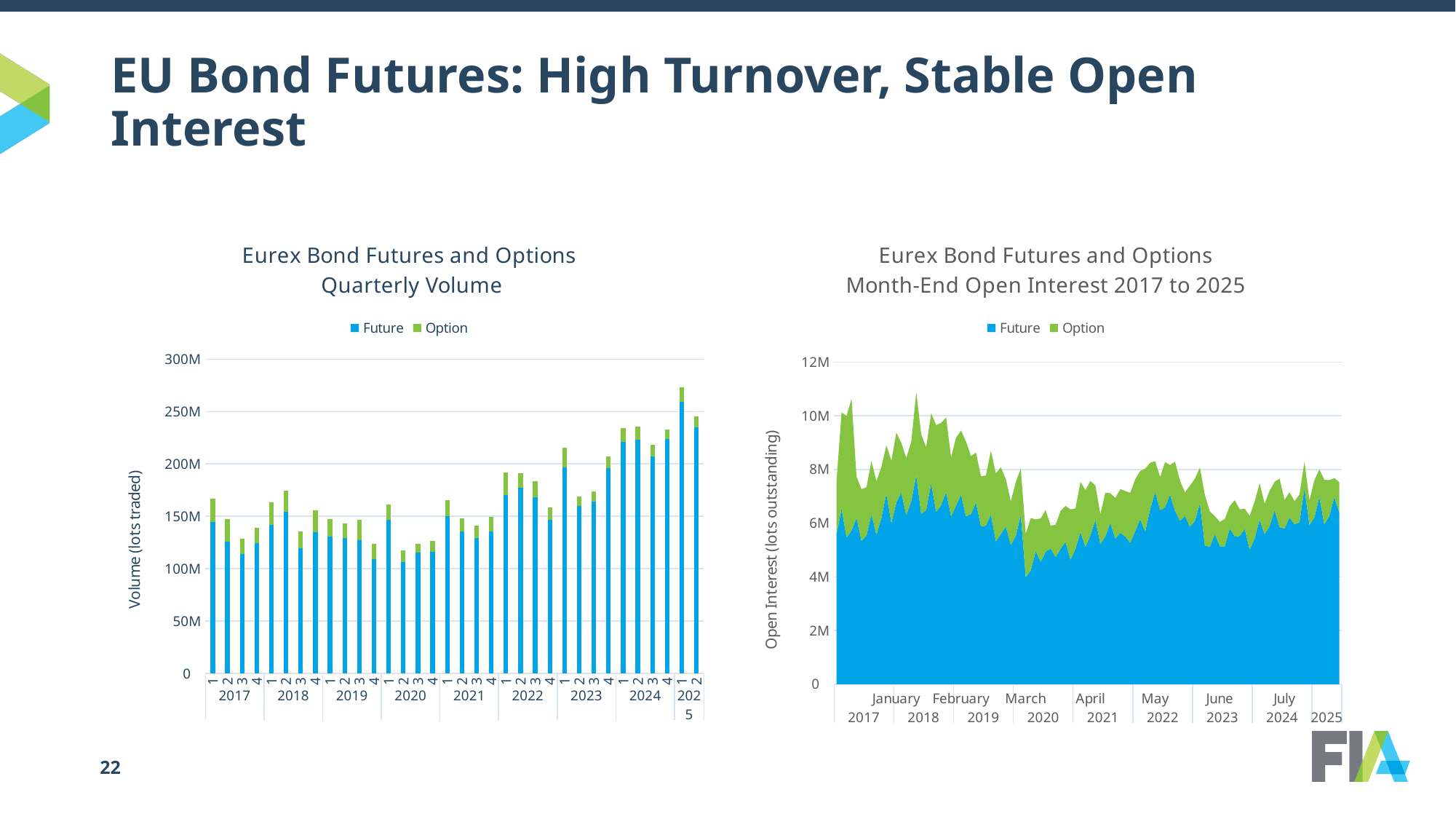
In the Quarterly Volume chart, which quarter has the highest total volume? Q1 2025 What kind of chart is the Month-End Open Interest 2017 to 2025 chart on the right? Stacked area chart In the Month-End Open Interest chart, is the lowest total open interest in 2020 greater or less than 6M? less How many series does the legend of the Quarterly Volume chart list? 2 In the Quarterly Volume chart, is the total volume for Q1 2024 greater or less than 200M? greater In the Quarterly Volume chart, which is larger: the total volume for Q1 2025 or Q2 2025? Q1 2025 What is the y-axis label of the Month-End Open Interest chart? Open Interest (lots outstanding) In the Quarterly Volume chart, is the total volume for Q1 2025 greater or less than 250M? greater In the Quarterly Volume chart, does total volume generally rise or fall from 2020 to 2025? Rise How many quarterly bars are plotted in the Quarterly Volume chart? 34 What kind of chart is the Eurex Bond Futures and Options Quarterly Volume chart on the left? Stacked bar chart